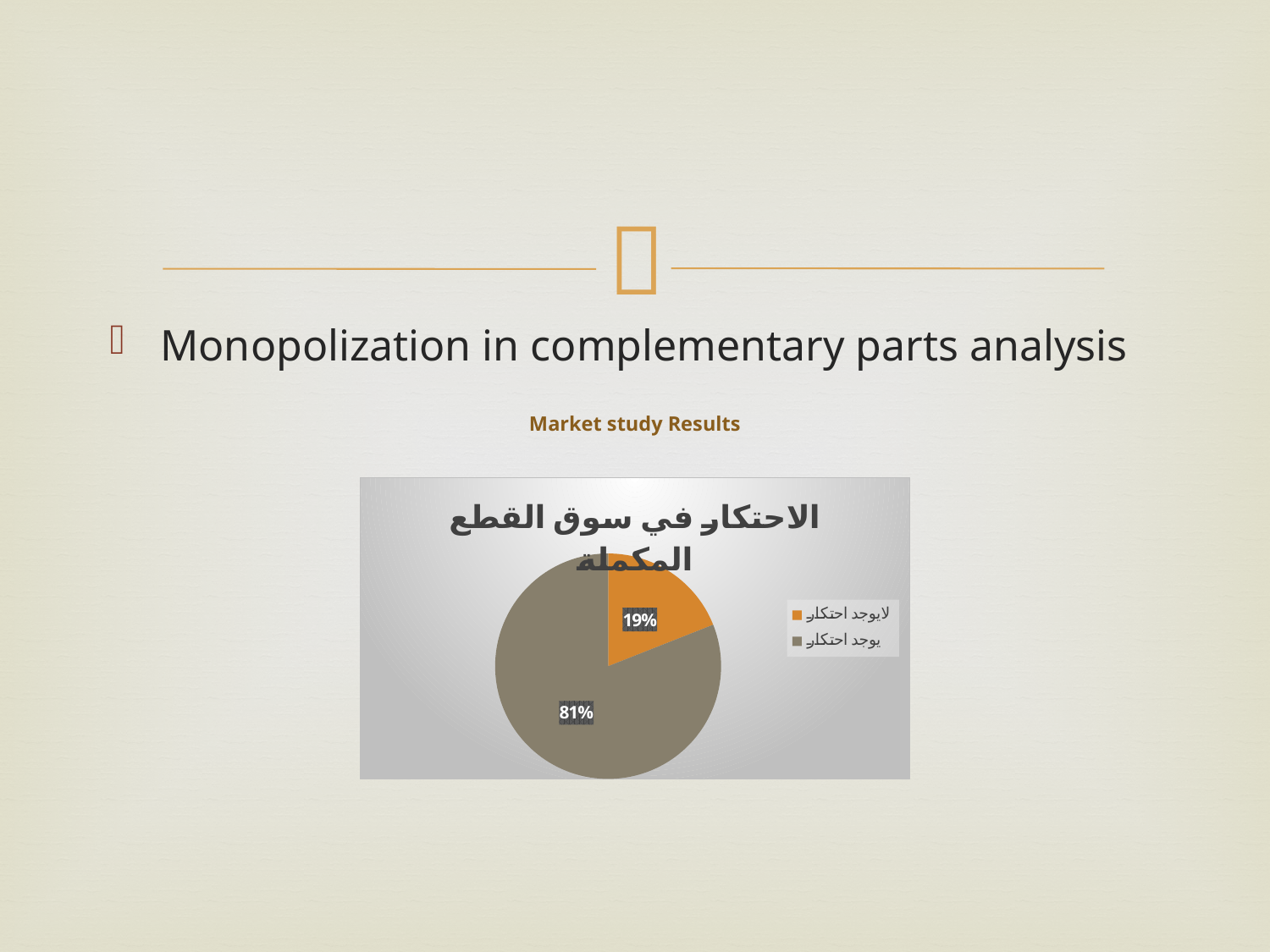
What colour is the slice labelled "لايوجد احتكار"? orange What kind of chart is shown on the slide? pie chart How many slices does the pie chart have? 2 What share of the pie does the slice labelled "لايوجد احتكار" (no monopoly) represent? 19% What share of the pie does the slice labelled "يوجد احتكار" (monopoly exists) represent? 81% Which is larger: the "يوجد احتكار" slice or the "لايوجد احتكار" slice? يوجد احتكار What is the title of the pie chart? الاحتكار في سوق القطع المكملة How many entries does the chart legend list? 2 What is the difference in percentage points between the "يوجد احتكار" slice and the "لايوجد احتكار" slice? 62 Which slice of the pie chart is the smallest? لايوجد احتكار Which slice of the pie chart is the largest? يوجد احتكار